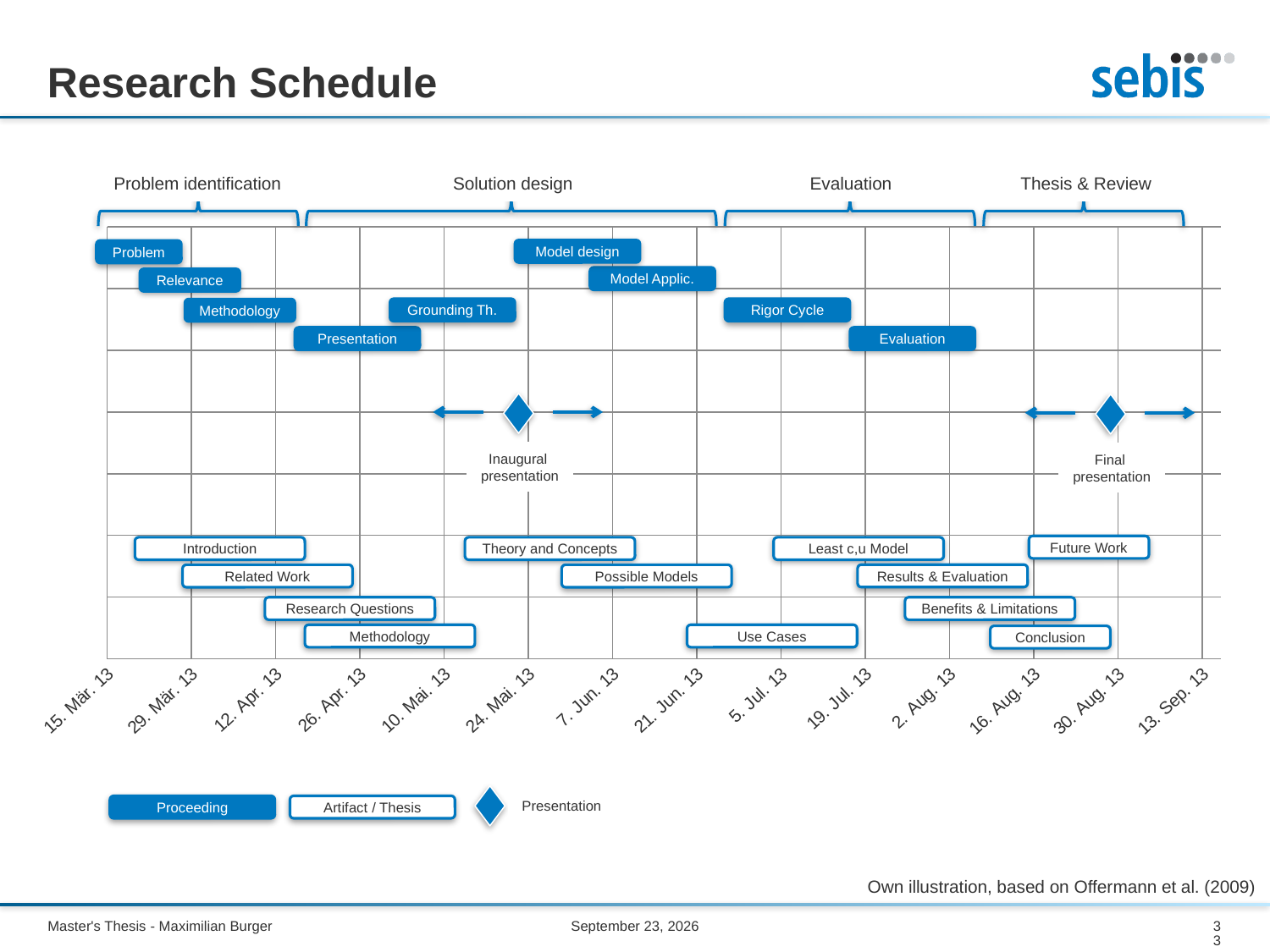
What is the last date shown on the x axis? 13. Sep. 13 How many presentation milestones (diamonds) are shown in the chart? 2 Which Proceeding task is the last one on the timeline? Evaluation Which research phase spans the longest period on the timeline? Solution design How many entries does the legend below the chart list? 3 According to the legend, what does a filled blue bar represent? Proceeding What kind of chart is shown on the slide? Gantt chart In which research phase does the Inaugural presentation milestone fall? Solution design How many research phases are labelled above the chart? 4 What is the first date shown on the x axis? 15. Mär. 13 Which milestone comes first on the timeline, the Inaugural presentation or the Final presentation? Inaugural presentation